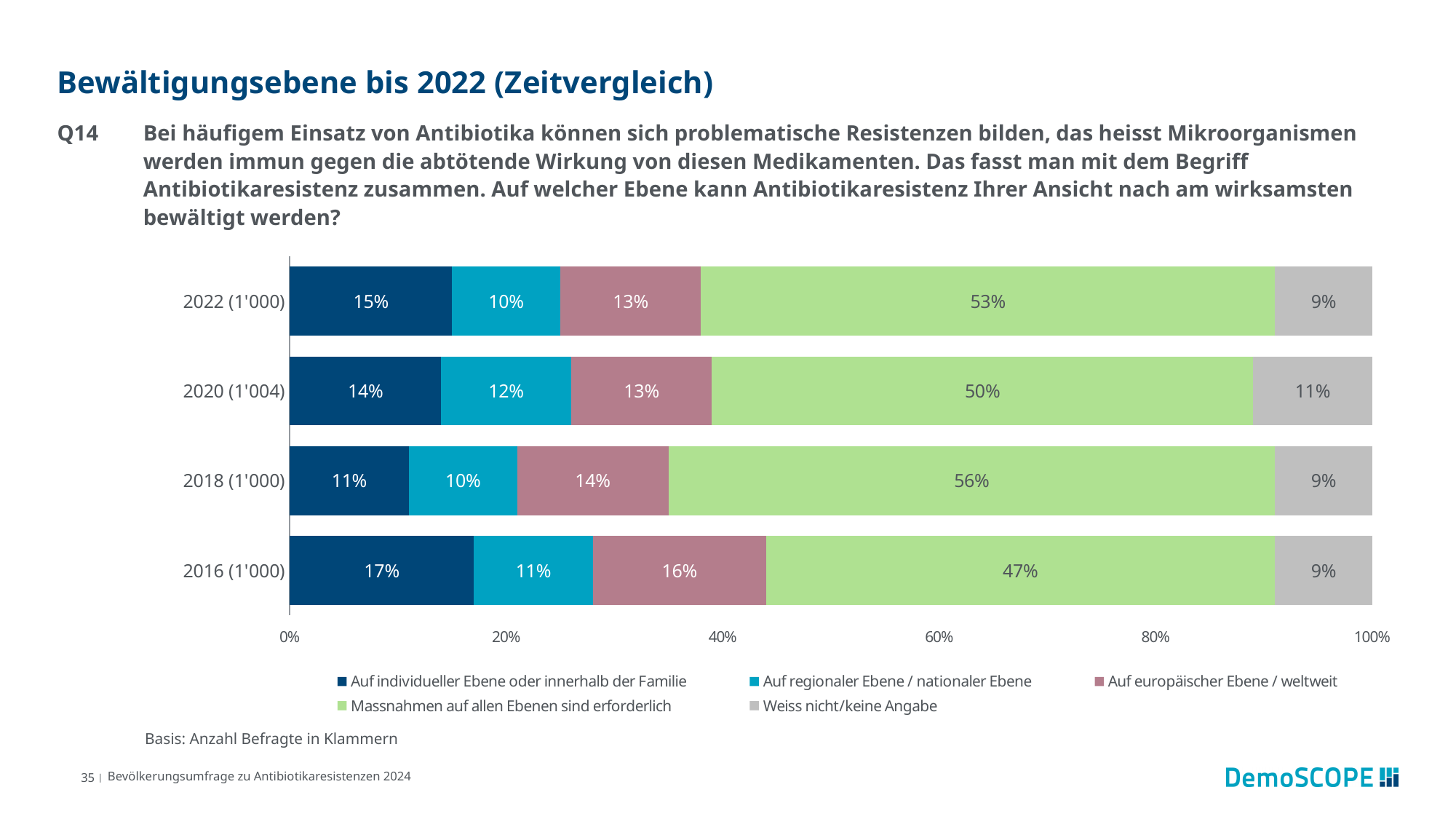
What kind of chart is shown on the slide? Stacked bar chart In which year was the share for "Auf individueller Ebene oder innerhalb der Familie" lowest? 2018 (1'000) How many series does the legend list? 5 In which year was the share for "Massnahmen auf allen Ebenen sind erforderlich" highest? 2018 (1'000) Which is larger: the "Auf europäischer Ebene / weltweit" value in 2016 (1'000) or in 2022 (1'000)? 2016 (1'000) What percentage of respondents in 2022 (1'000) chose "Massnahmen auf allen Ebenen sind erforderlich"? 53% What is the combined share of "Auf individueller Ebene oder innerhalb der Familie" and "Auf regionaler Ebene / nationaler Ebene" in 2020 (1'004)? 26% What is the value for "Weiss nicht/keine Angabe" in 2020 (1'004)? 11% What is the difference between the "Massnahmen auf allen Ebenen sind erforderlich" values for 2018 (1'000) and 2016 (1'000)? 9 percentage points Which legend entry is shown in light green? Massnahmen auf allen Ebenen sind erforderlich How many years (bars) are shown in the chart? 4 What is the value for "Auf individueller Ebene oder innerhalb der Familie" in 2016 (1'000)? 17%